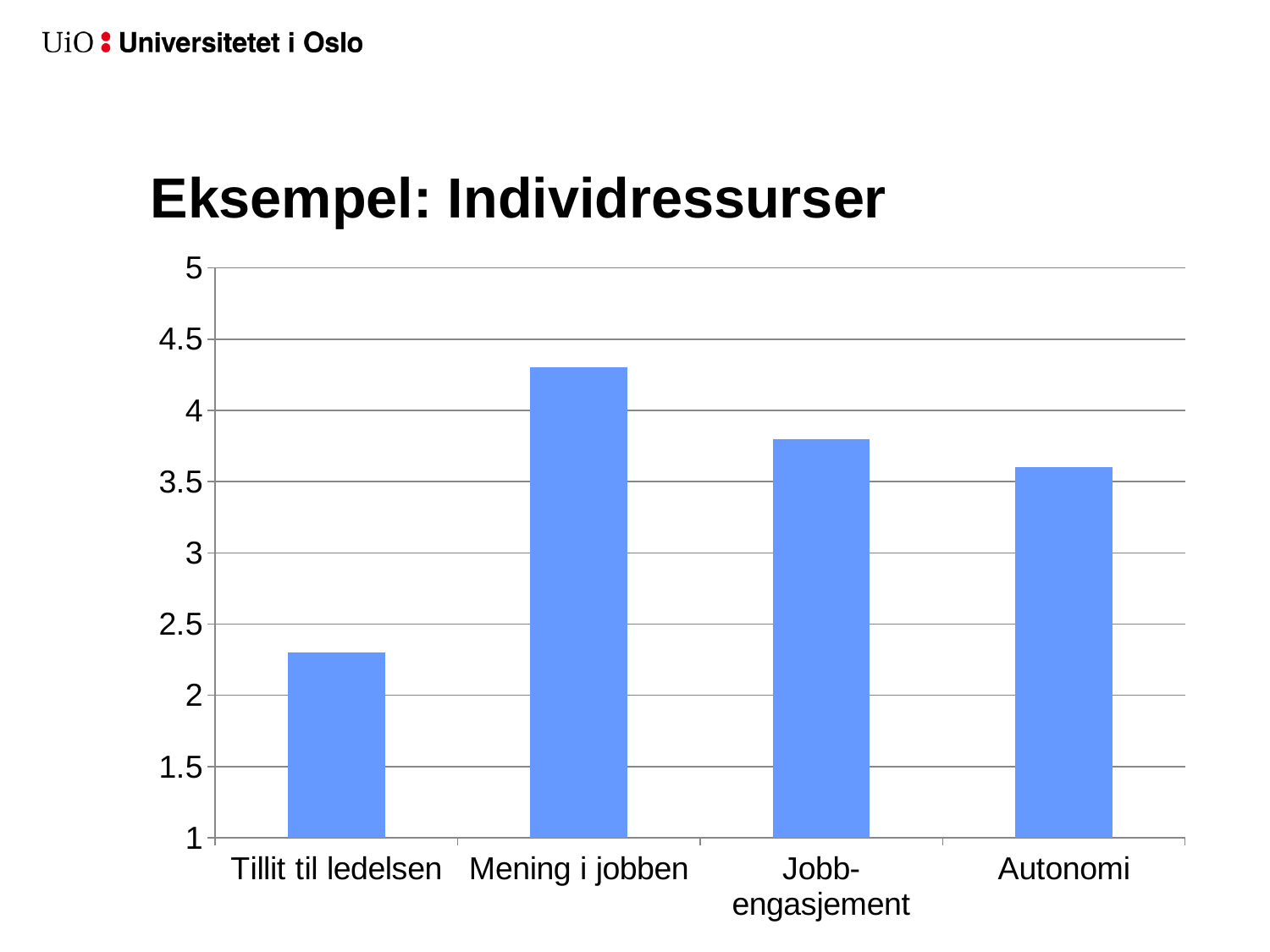
What kind of chart is shown on the slide? bar chart Which category has the highest bar? Mening i jobben Which is larger, the value for Tillit til ledelsen or the value for Autonomi? Autonomi Which is larger, the value for Jobb-engasjement or the value for Autonomi? Jobb-engasjement Is the value for Tillit til ledelsen greater or less than 2.5? less What is the title of the slide containing the chart? Eksempel: Individressurser Is the value for Jobb-engasjement greater or less than 4? less Is the value for Mening i jobben greater or less than 4? greater How many categories are shown on the x axis of the chart? 4 Which category has the lowest bar? Tillit til ledelsen